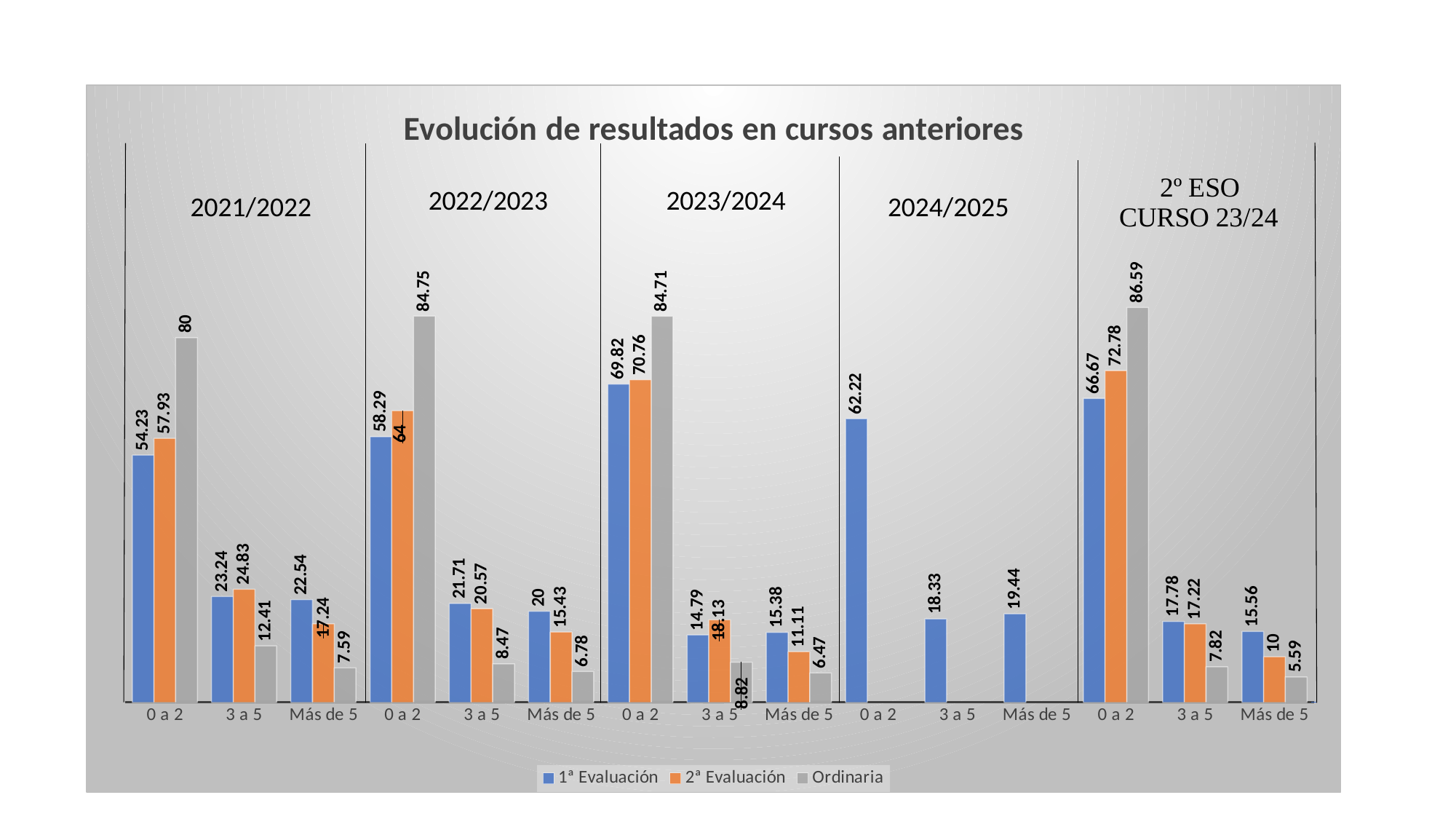
What is the Ordinaria value for '0 a 2' in the 2º ESO CURSO 23/24 group? 86.59 How many series have bars in the 2024/2025 group? 1 What is the lowest Ordinaria value shown in the chart? 5.59 Which group has the highest Ordinaria value for '0 a 2'? 2º ESO CURSO 23/24 What is the difference between the Ordinaria and 1ª Evaluación values for '0 a 2' in 2021/2022? 25.77 What is the 1ª Evaluación value for 'Más de 5' in 2024/2025? 19.44 What is the 2ª Evaluación value for '0 a 2' in 2022/2023? 64 What kind of chart is shown on the slide? bar chart Which is larger in 2023/2024 for '3 a 5': 1ª Evaluación or 2ª Evaluación? 2ª Evaluación What is the title of the chart? Evolución de resultados en cursos anteriores What is the Ordinaria value for '0 a 2' in 2021/2022? 80 How many series does the legend list? 3